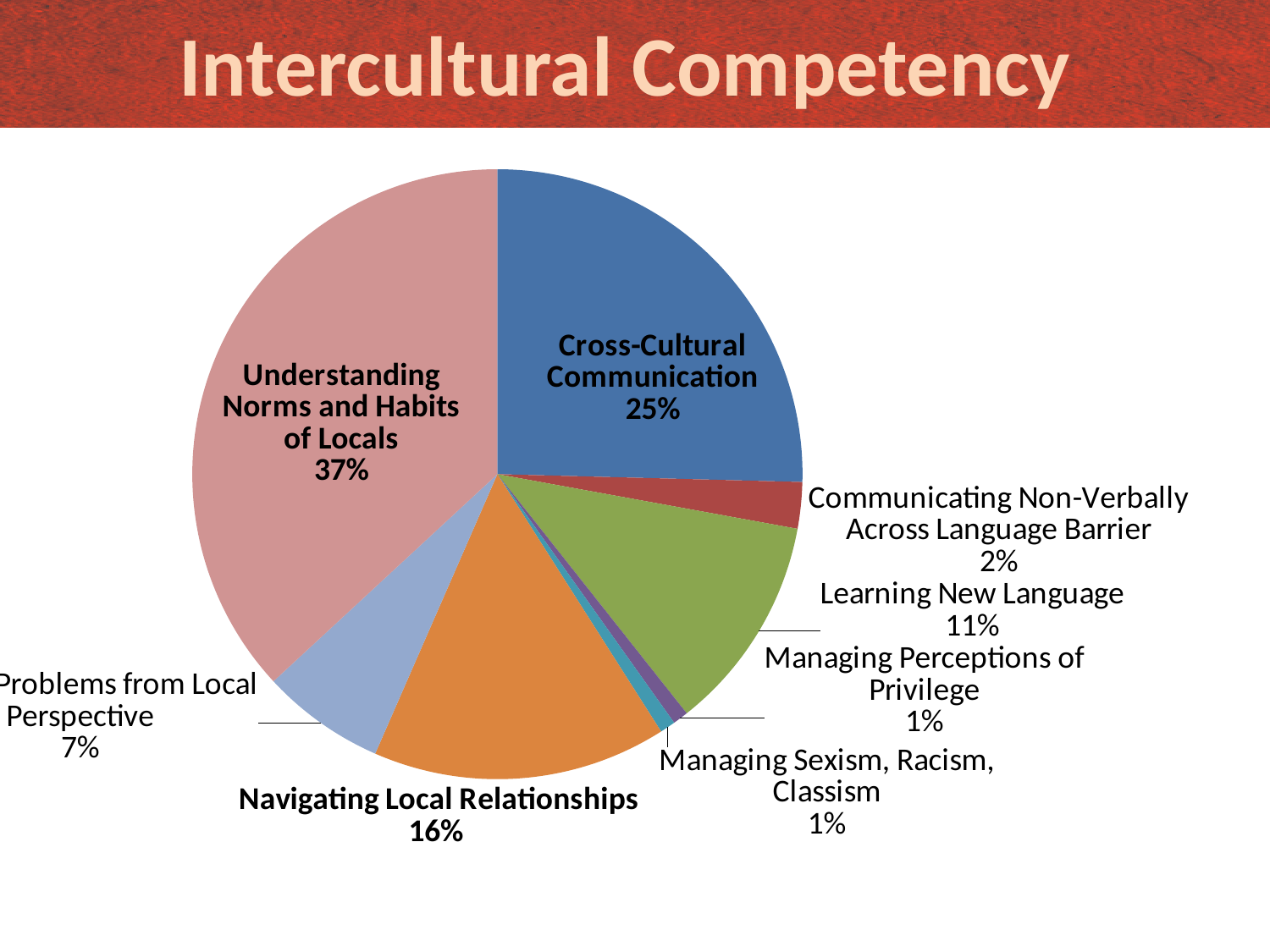
What percentage is shown for Learning New Language? 11% What share of the pie does Cross-Cultural Communication represent? 25% What is the title of the slide containing the pie chart? Intercultural Competency Which is larger, Navigating Local Relationships or Learning New Language? Navigating Local Relationships What percentage is shown for Communicating Non-Verbally Across Language Barrier? 2% How many slices does the pie chart have? 8 What is the difference in percentage points between Understanding Norms and Habits of Locals and Cross-Cultural Communication? 12 What type of chart is shown on the slide? pie chart Which category has the largest slice of the pie? Understanding Norms and Habits of Locals What percentage is shown for Understanding Norms and Habits of Locals? 37% What percentage is shown for Navigating Local Relationships? 16% What is the combined share of Managing Perceptions of Privilege and Managing Sexism, Racism, Classism? 2%